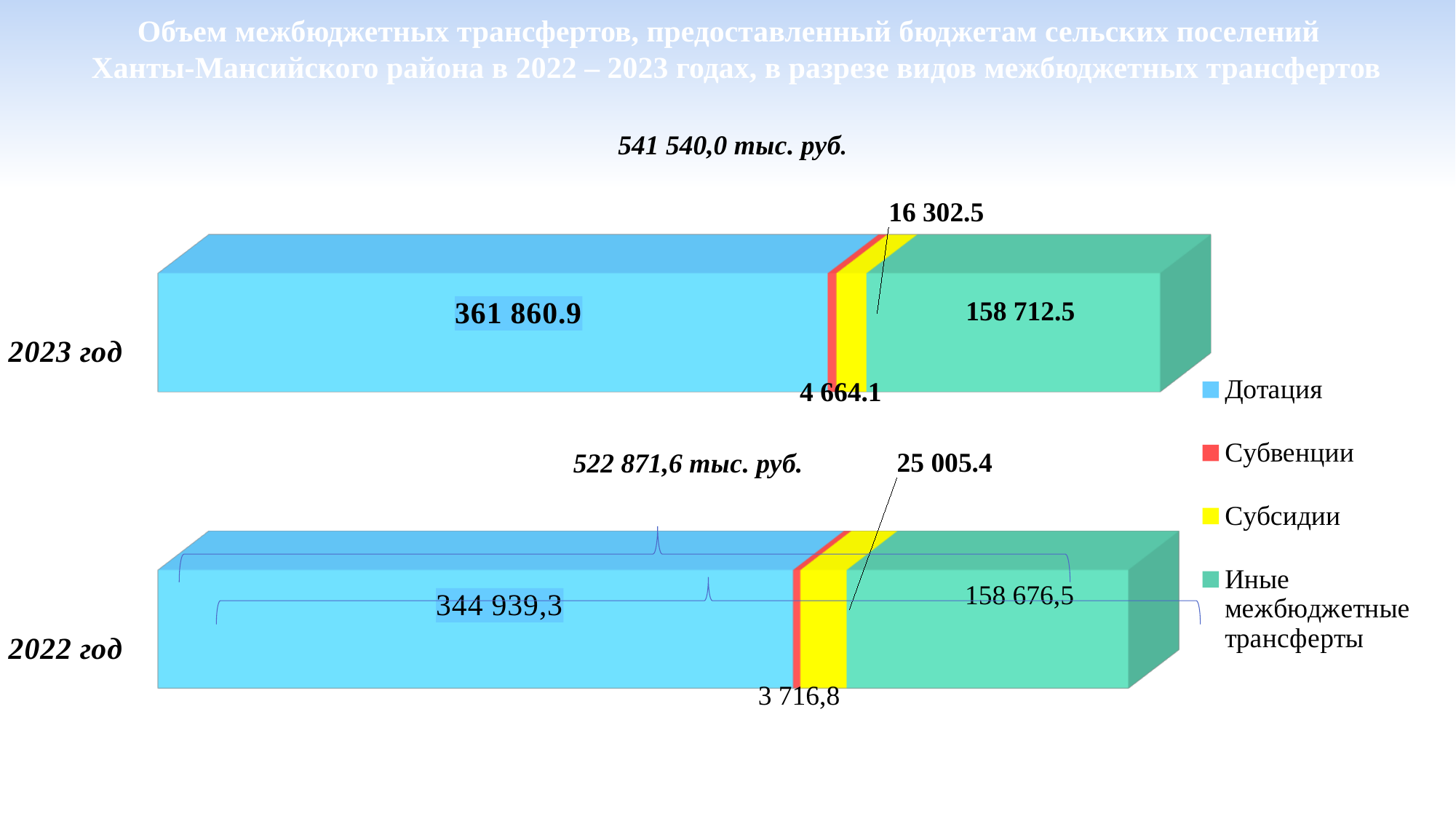
What is the value of Субсидии for 2022 год? 25 005.4 What is the value of Дотация for 2023 год? 361 860.9 What is the total of the 2023 год bar as printed on the slide? 541 540,0 тыс. руб. What is the value of Иные межбюджетные трансферты for 2022 год? 158 676,5 What type of chart is shown on the slide? stacked bar chart Which year has the larger Дотация value, 2022 год or 2023 год? 2023 год Which series has the largest value in the 2023 год bar? Дотация How many series does the legend list? 4 How many bars (years) are plotted on the chart? 2 Which series has the smallest value in the 2022 год bar? Субвенции What is the difference between the Субсидии values for 2022 год and 2023 год? 8 702.9 What is the value of Субвенции for 2023 год? 4 664.1